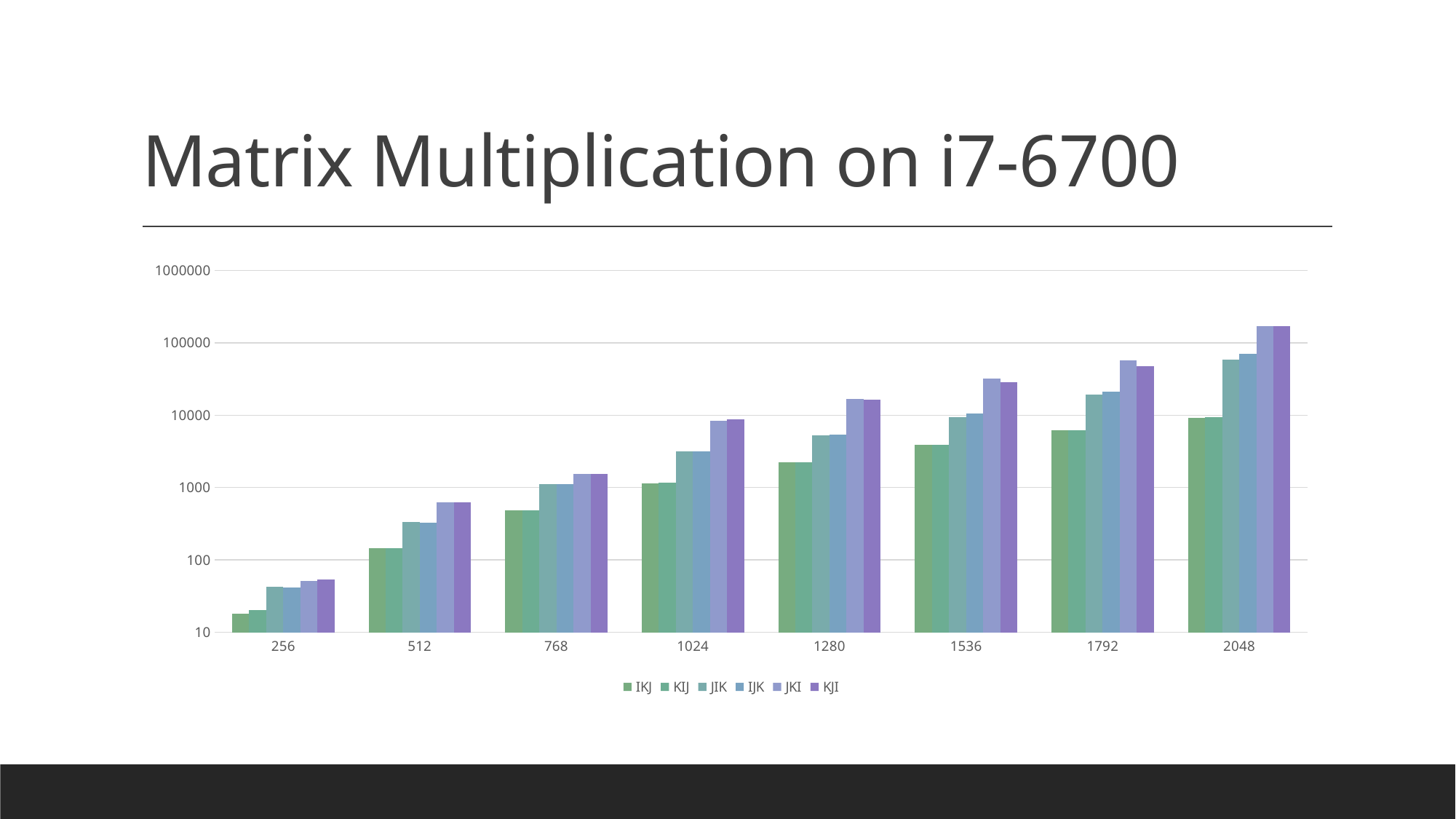
What is the title of the chart on the slide? Matrix Multiplication on i7-6700 At matrix size 1792, which is larger, JKI or KJI? JKI Is the value for IKJ at 256 greater or less than 100? less Is the value for IKJ at 2048 greater or less than 1000? greater How many matrix sizes (categories) are shown on the x axis? 8 How many series does the legend list? 6 Is the value for JIK at 1024 greater or less than 1000? greater What kind of chart is shown on the slide? bar chart Do the values for the IKJ series rise or fall as the matrix size increases along the x axis? rise Which series is listed first in the legend? IKJ